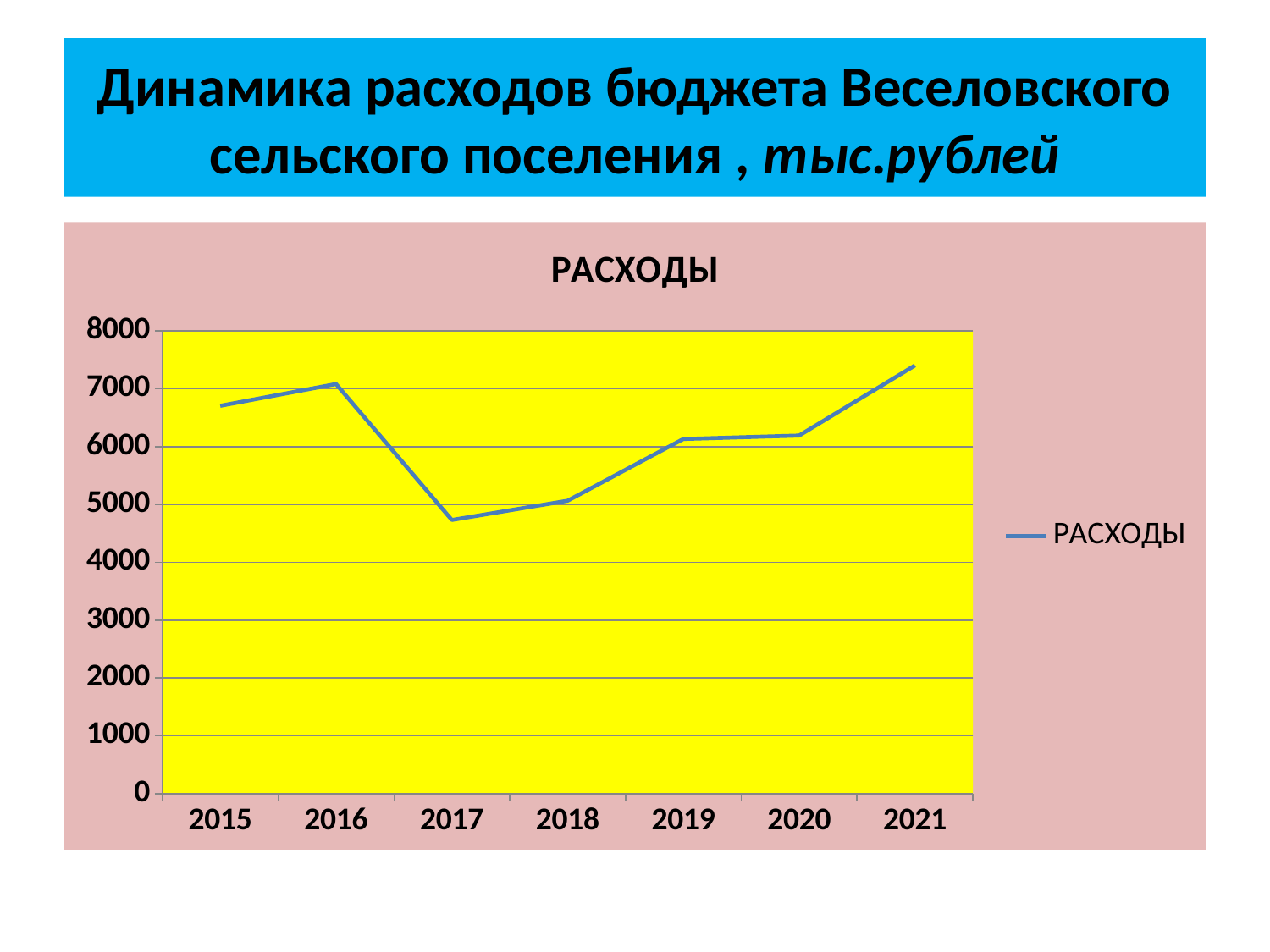
How many series does the legend list? 1 Which year has the lowest value for РАСХОДЫ? 2017 Is the value for 2017 greater or less than 5000? less Is the value for 2015 greater or less than 7000? less Which year has the highest value for РАСХОДЫ? 2021 Which year has the larger value, 2016 or 2017? 2016 What kind of chart is shown on the slide? line chart Do the values rise or fall from 2017 to 2021? rise How many years are plotted on the x axis of the chart? 7 What is the title of the chart? РАСХОДЫ Is the value for 2019 greater or less than 6000? greater